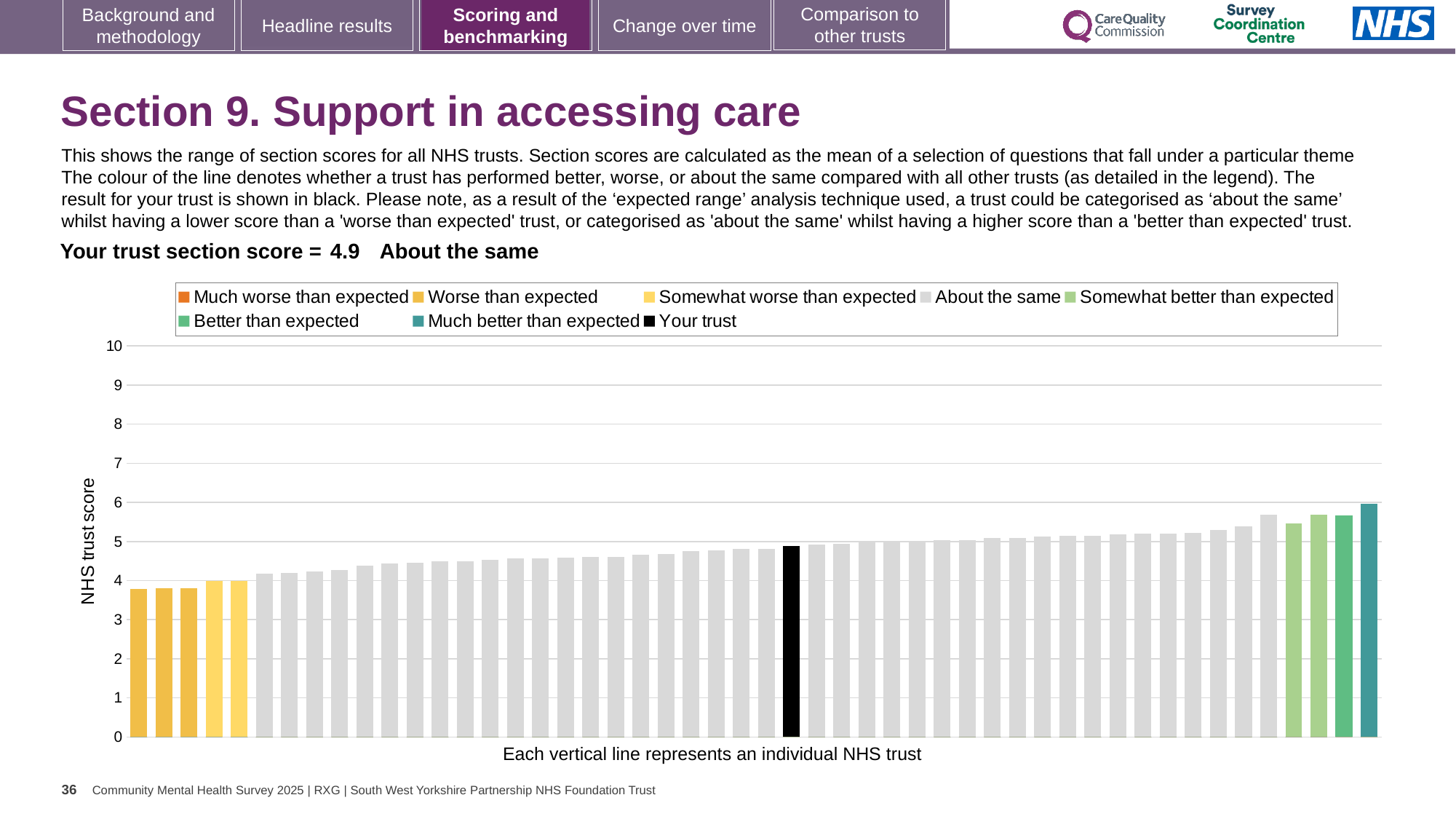
Is the value of the tallest bar greater or less than 7? less Do the bar values rise or fall from left to right along the x axis? rise What is the title of the vertical axis? NHS trust score Which legend category does the tallest bar belong to? Much better than expected Is the value of the shortest bar greater or less than 5? less Is the value for the black 'Your trust' bar greater or less than 4? greater How many bars are coloured black for 'Your trust'? 1 What is the section score for your trust? 4.9 Which category does your trust's section score fall into? About the same What kind of chart is shown on the slide? bar chart How many entries does the chart legend list? 8